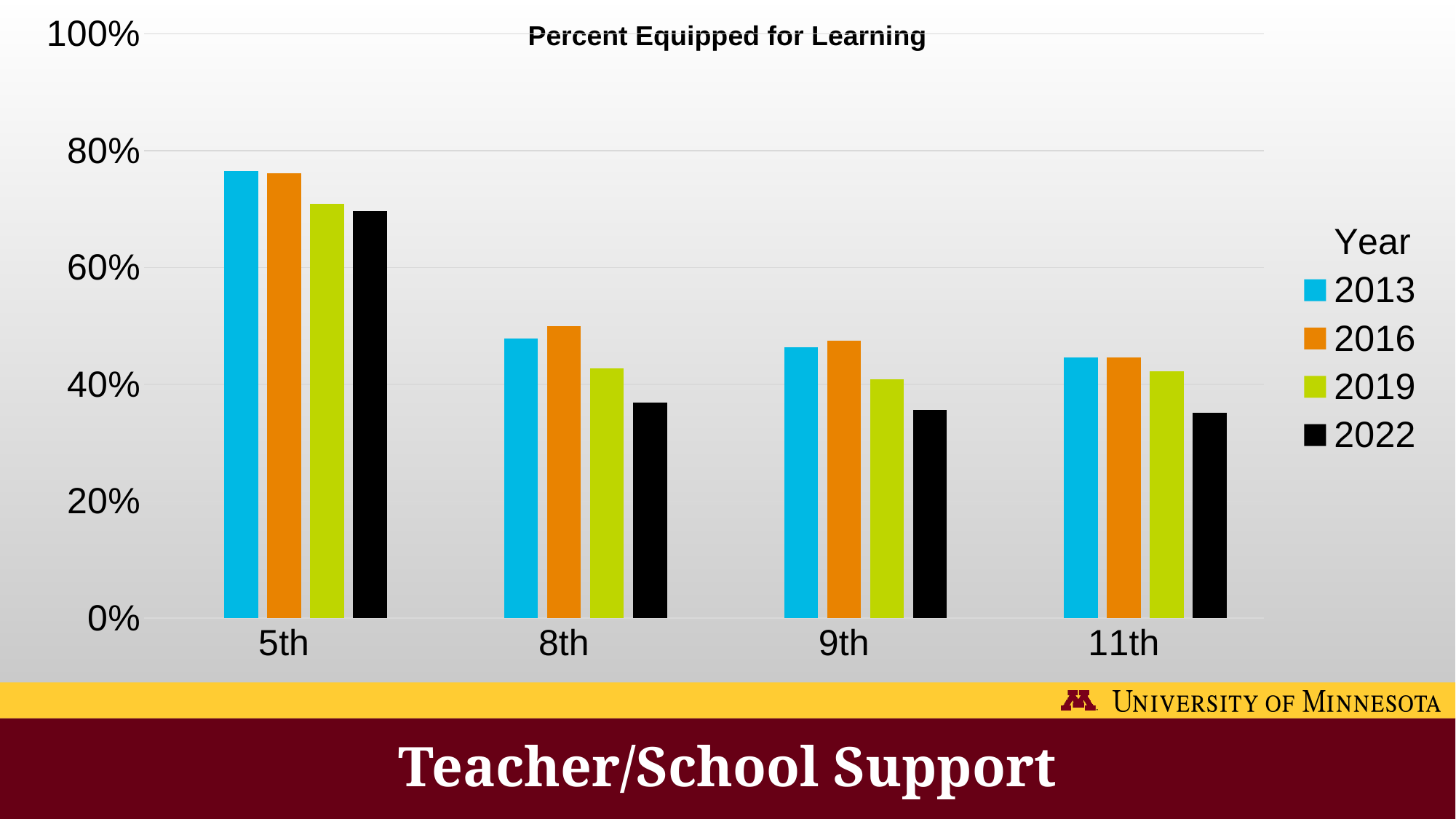
Which colour represents the 2022 series? black What kind of chart is shown on the slide? bar chart Which is larger: the 2013 value for 5th grade or the 2013 value for 8th grade? 5th grade Which grade has the highest value for 2013? 5th Is the value for 5th grade in 2013 greater or less than 60%? greater Is the value for 8th grade in 2022 greater or less than 40%? less What is the title of the chart? Percent Equipped for Learning Within the 8th grade group, which year has the lowest value? 2022 How many series does the legend list? 4 How many grade categories are shown on the x axis? 4 Is the value for 8th grade in 2016 greater or less than 40%? greater